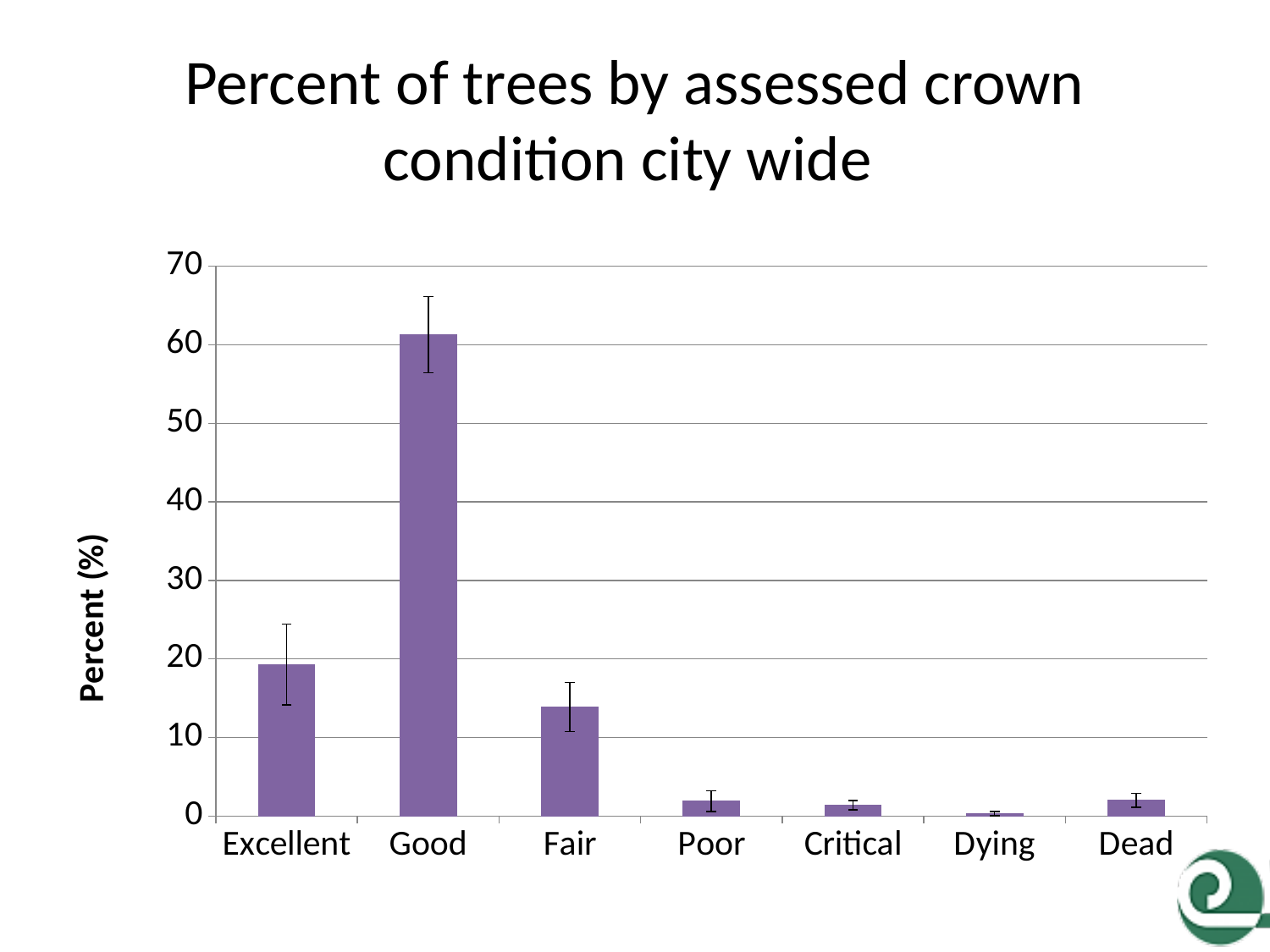
Which crown condition category has the highest percentage of trees? Good How many crown condition categories are shown on the x axis? 7 Is the value for Good greater or less than 60? greater Which has a higher percentage of trees, Good or Excellent? Good Is the value for Poor greater or less than 10? less What is the label on the vertical axis? Percent (%) Which crown condition category has the lowest percentage of trees? Dying Which has a higher percentage of trees, Excellent or Fair? Excellent What is the title of the chart? Percent of trees by assessed crown condition city wide Is the value for Fair greater or less than 10? greater What type of chart is shown on the slide? Bar chart